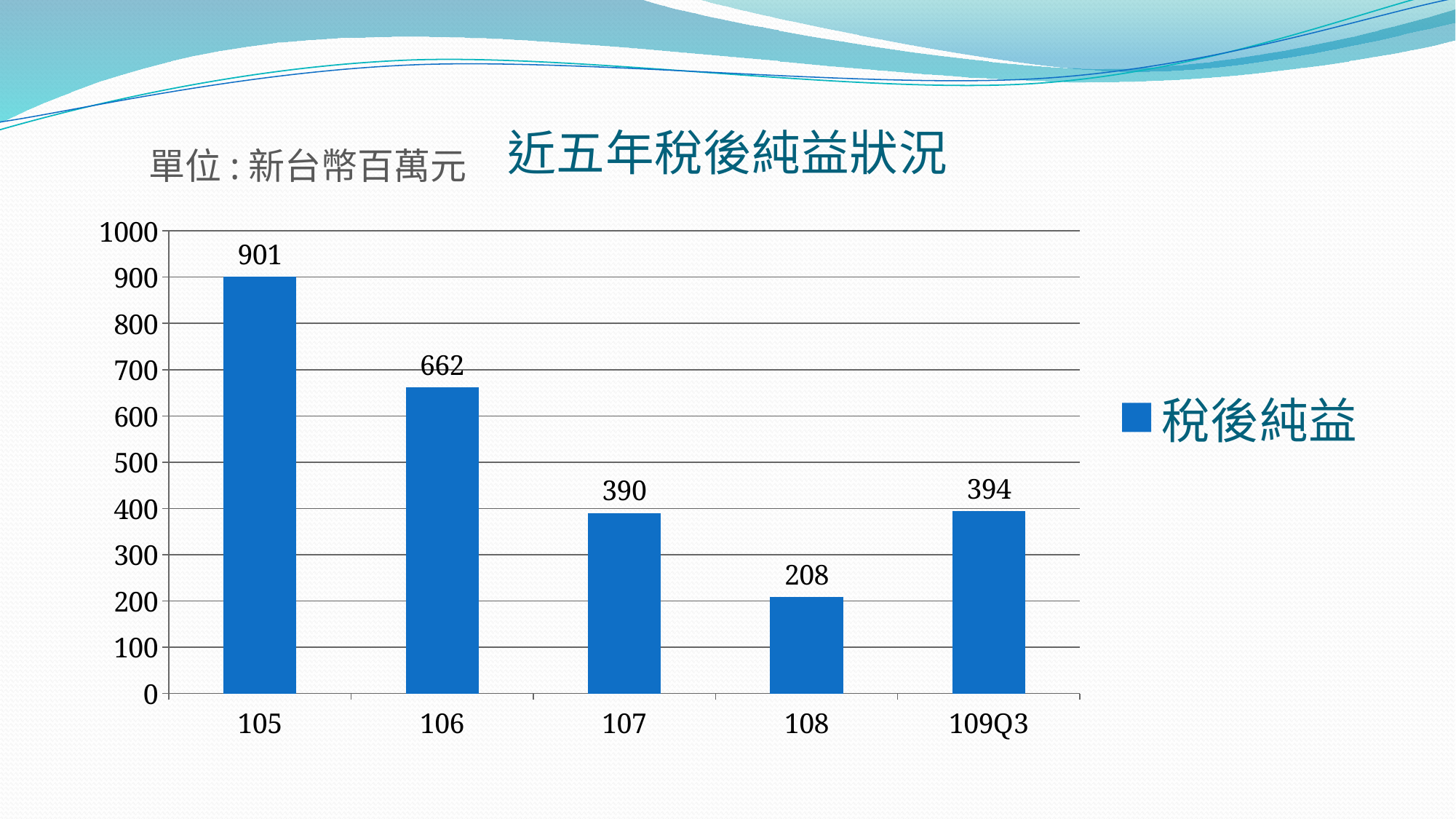
What kind of chart is shown on the slide? bar chart Which is larger, the value for 106 or the value for 107? 106 What is the value for 109Q3? 394 Is the value for 106 greater or less than 600? greater Which category has the highest value? 105 What is the title of the chart? 近五年稅後純益狀況 How many categories are shown on the x axis? 5 Which category has the lowest value? 108 What is the difference between the values for 105 and 106? 239 What is the value for 105? 901 What is the difference between the values for 107 and 108? 182 What is the value for 108? 208